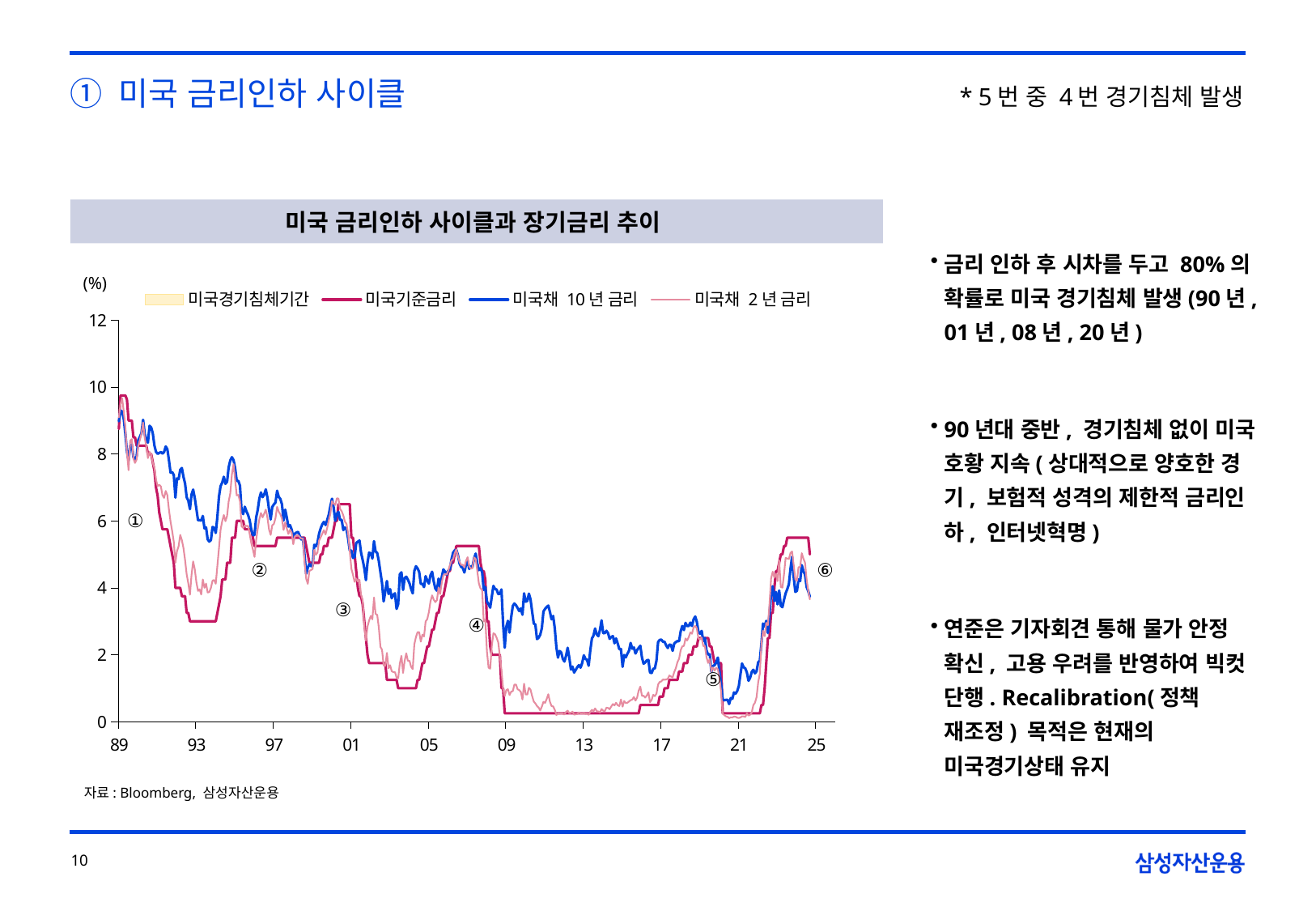
Is the value of 미국채 10년 금리 around 21 greater or less than 2? less What kind of chart is shown on the slide? line chart Is the value of 미국채 10년 금리 at 89 greater or less than 8? greater Is the peak value of 미국기준금리 after 21 greater or less than 4? greater What is the title of the chart? 미국 금리인하 사이클과 장기금리 추이 What is the highest tick value shown on the y axis? 12 Does 미국채 10년 금리 generally rise or fall from 89 to 13? fall How many series does the chart legend list? 4 Which is larger: 미국기준금리 at 89 or 미국기준금리 at 13? 미국기준금리 at 89 What source is cited below the chart? Bloomberg, 삼성자산운용 How many year labels are shown on the x axis? 10